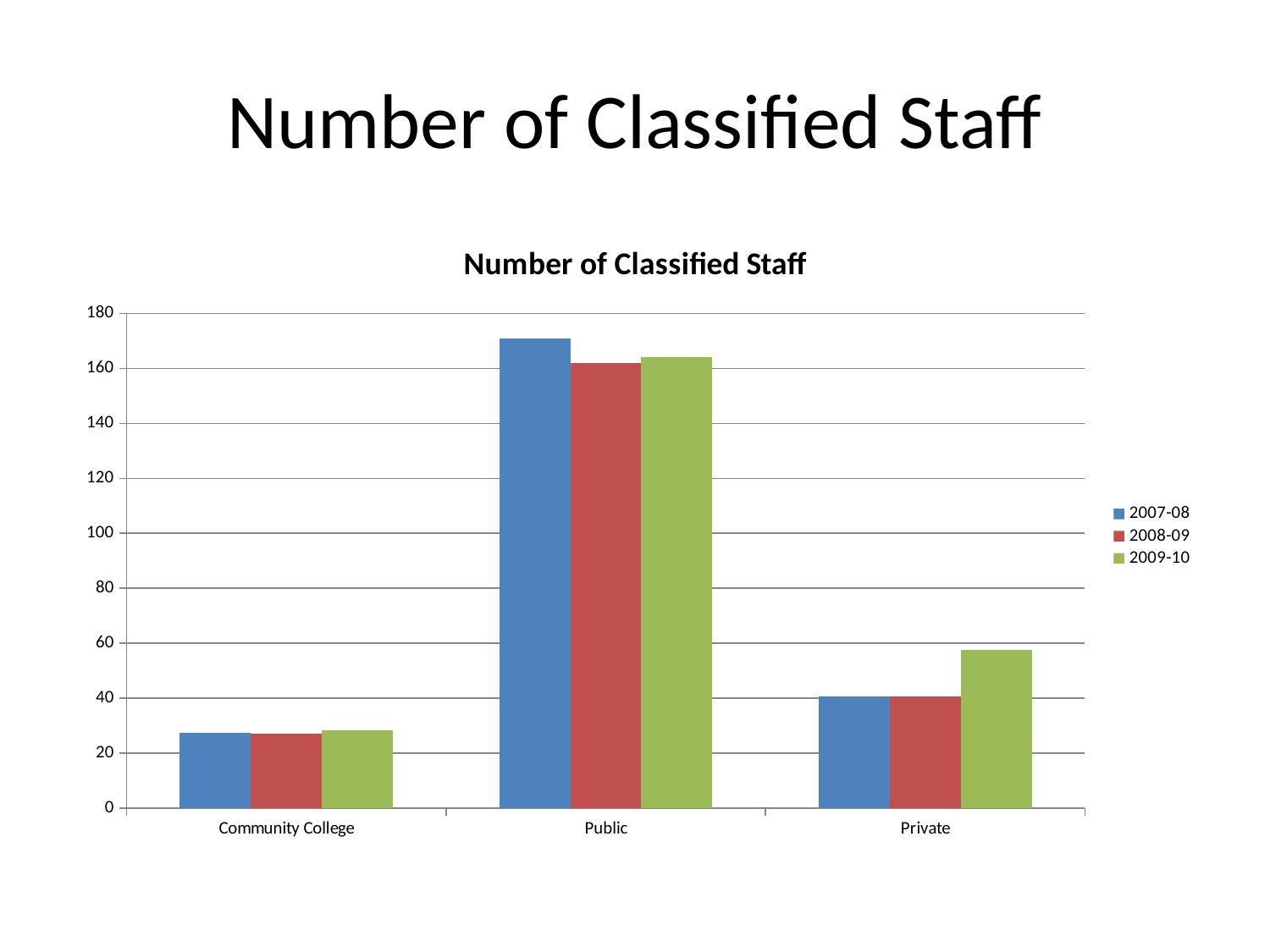
What is the title of the chart? Number of Classified Staff Is the value for Public in 2007-08 greater or less than 160? greater For the Private category, which is larger: the 2007-08 value or the 2009-10 value? 2009-10 How many categories are shown on the x axis of the chart? 3 What kind of chart is shown on the slide? bar chart Is the value for Private in 2007-08 greater or less than 60? less How many series does the legend list? 3 Which series has the tallest bar in the Public category? 2007-08 Is the value for Private in 2009-10 greater or less than 40? greater Which category has the lowest number of classified staff? Community College Which category has the highest number of classified staff? Public